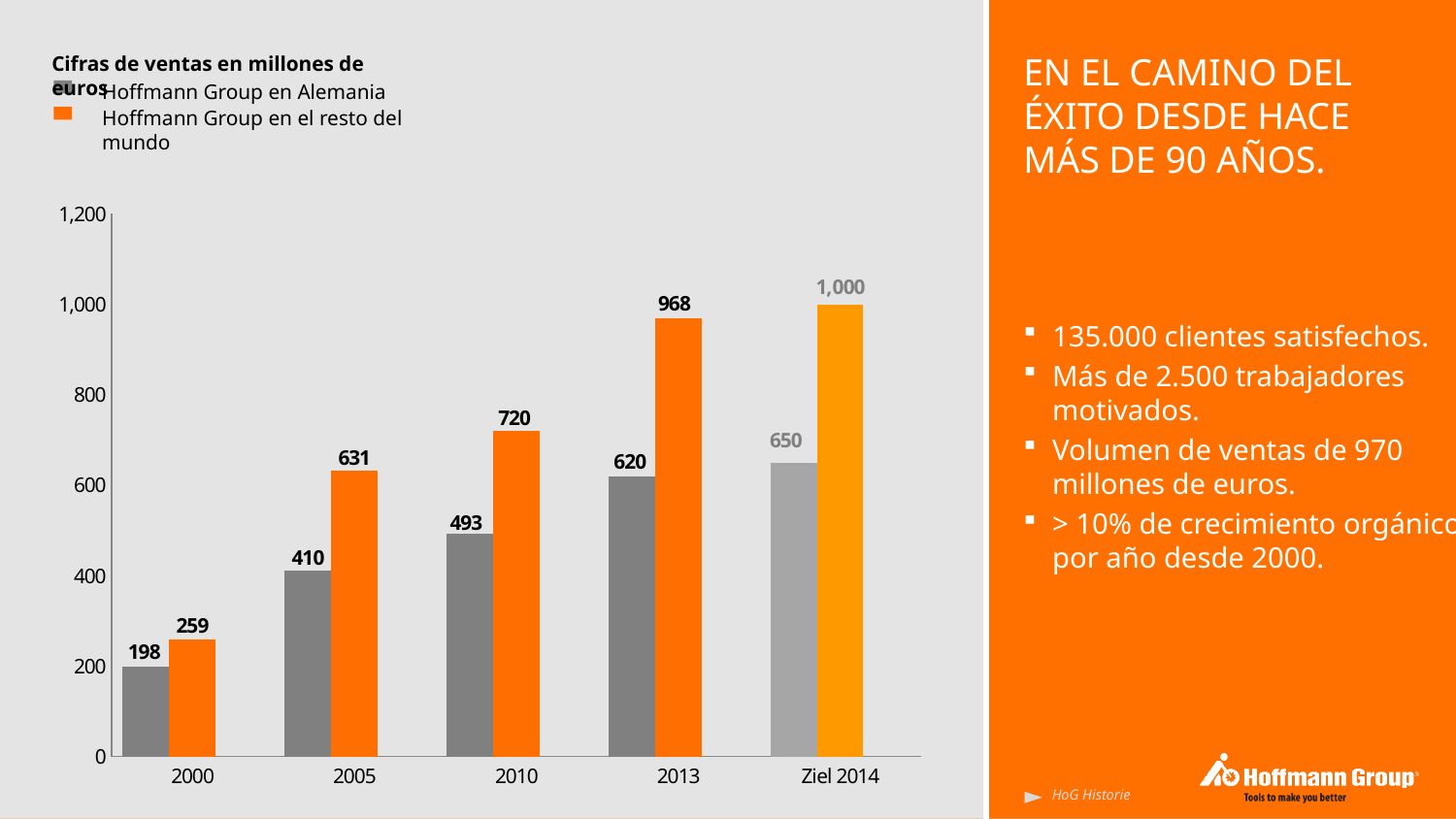
What is the value for Hoffmann Group en el resto del mundo in 2013? 968 Which is larger in 2013: Hoffmann Group en Alemania or Hoffmann Group en el resto del mundo? Hoffmann Group en el resto del mundo How many categories are shown on the x axis? 5 Which category has the highest value for Hoffmann Group en el resto del mundo? Ziel 2014 What is the value for Hoffmann Group en el resto del mundo for Ziel 2014? 1,000 What kind of chart is shown on the slide? Bar chart Do the values for Hoffmann Group en Alemania rise or fall from 2000 to Ziel 2014? Rise What is the title of the chart? Cifras de ventas en millones de euros What is the difference between the Hoffmann Group en el resto del mundo value and the Hoffmann Group en Alemania value in 2005? 221 Which year has the lowest value for Hoffmann Group en Alemania? 2000 What is the value for Hoffmann Group en Alemania in 2010? 493 How many series does the legend list? 2